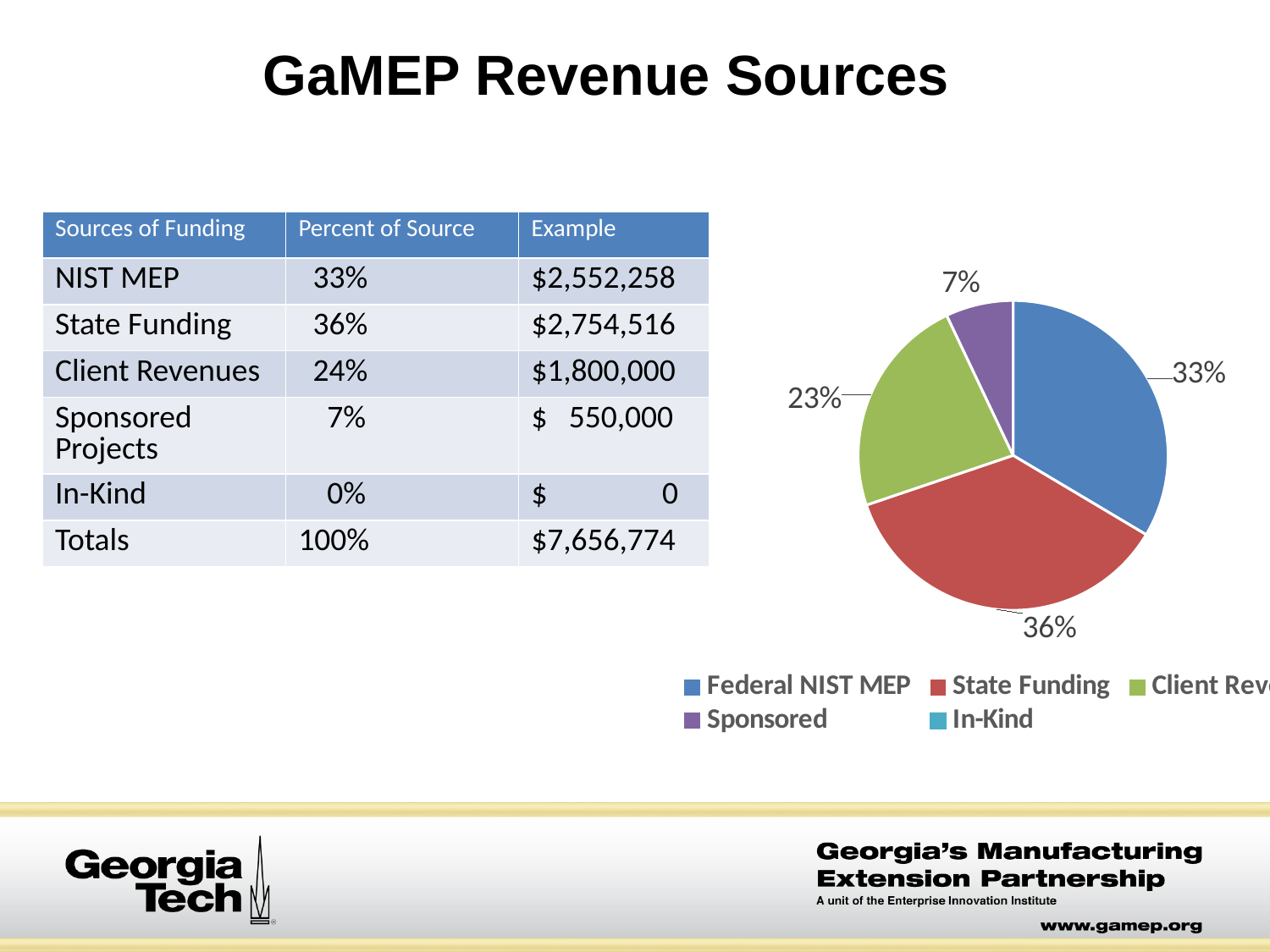
Which slice of the pie chart has the largest share? State Funding In the pie chart, what is the difference between the State Funding share and the Federal NIST MEP share? 3% In the pie chart, what percentage is labelled on the green slice? 23% In the pie chart, which is larger: the Federal NIST MEP slice or the Sponsored slice? Federal NIST MEP In the pie chart, what share is labelled for the Federal NIST MEP slice? 33% What kind of chart is shown on the right of the slide? pie chart What colour is the State Funding slice in the pie chart? red In the pie chart, what share is labelled for the State Funding slice? 36% In the pie chart, what is the difference between the Federal NIST MEP share and the Sponsored share? 26% Which labelled slice of the pie chart has the smallest share? Sponsored In the pie chart, what share is labelled for the Sponsored slice? 7% How many entries does the pie chart's legend list? 5